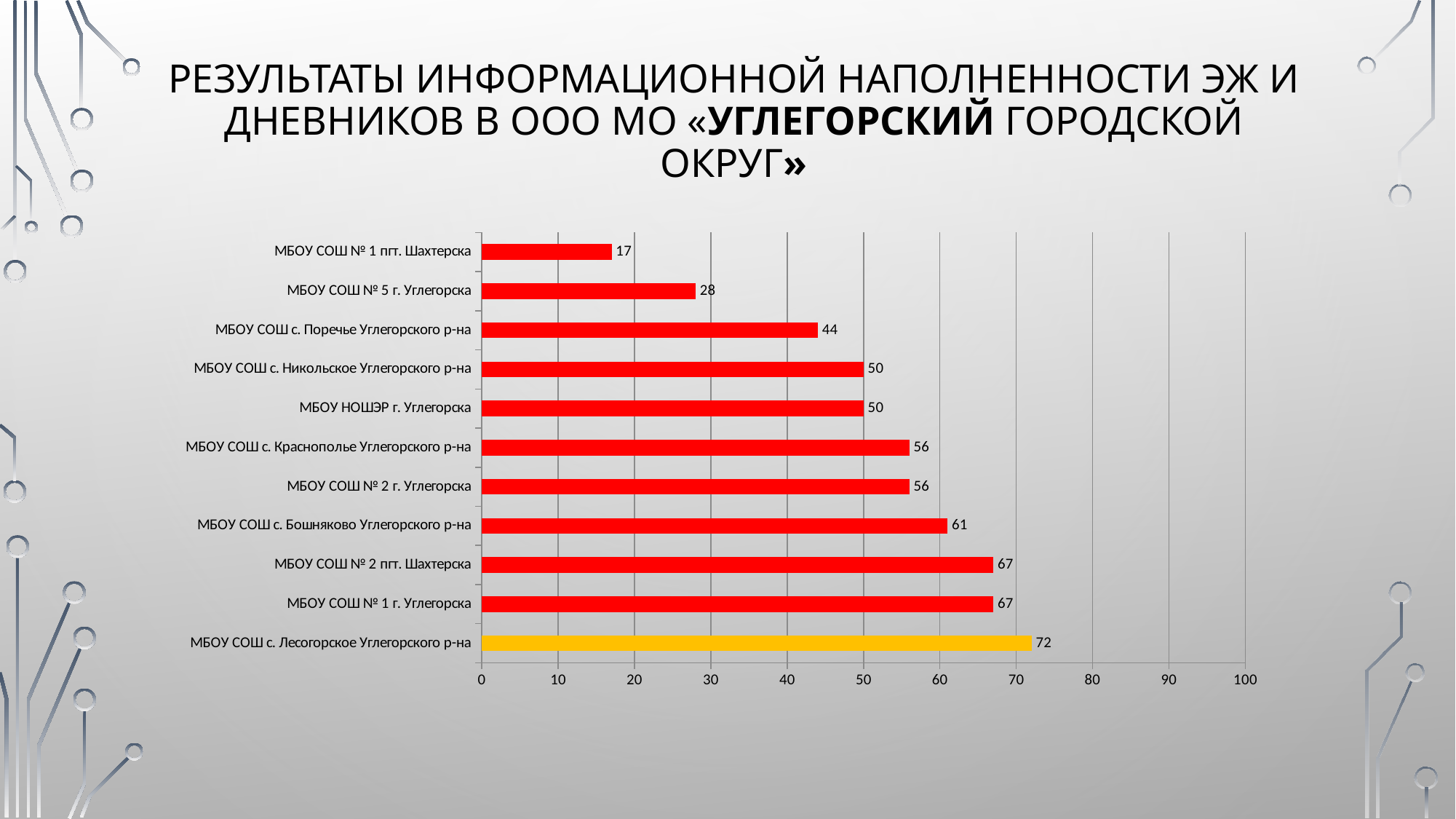
How many schools are shown in the chart? 11 What is the value for МБОУ СОШ с. Бошняково Углегорского р-на? 61 Which is larger, the value for МБОУ СОШ с. Краснополье Углегорского р-на or the value for МБОУ СОШ с. Поречье Углегорского р-на? МБОУ СОШ с. Краснополье Углегорского р-на What kind of chart is shown on the slide? bar chart Is the value for МБОУ СОШ № 2 пгт. Шахтерска greater or less than 60? greater What is the maximum value shown on the horizontal axis? 100 Which bar is coloured differently (yellow) from the others? МБОУ СОШ с. Лесогорское Углегорского р-на What is the value for МБОУ СОШ с. Поречье Углегорского р-на? 44 Which school has the lowest value? МБОУ СОШ № 1 пгт. Шахтерска Which school has the highest value? МБОУ СОШ с. Лесогорское Углегорского р-на What is the difference between the values for МБОУ СОШ с. Лесогорское Углегорского р-на and МБОУ СОШ № 5 г. Углегорска? 44 What is the value for МБОУ СОШ № 1 пгт. Шахтерска? 17